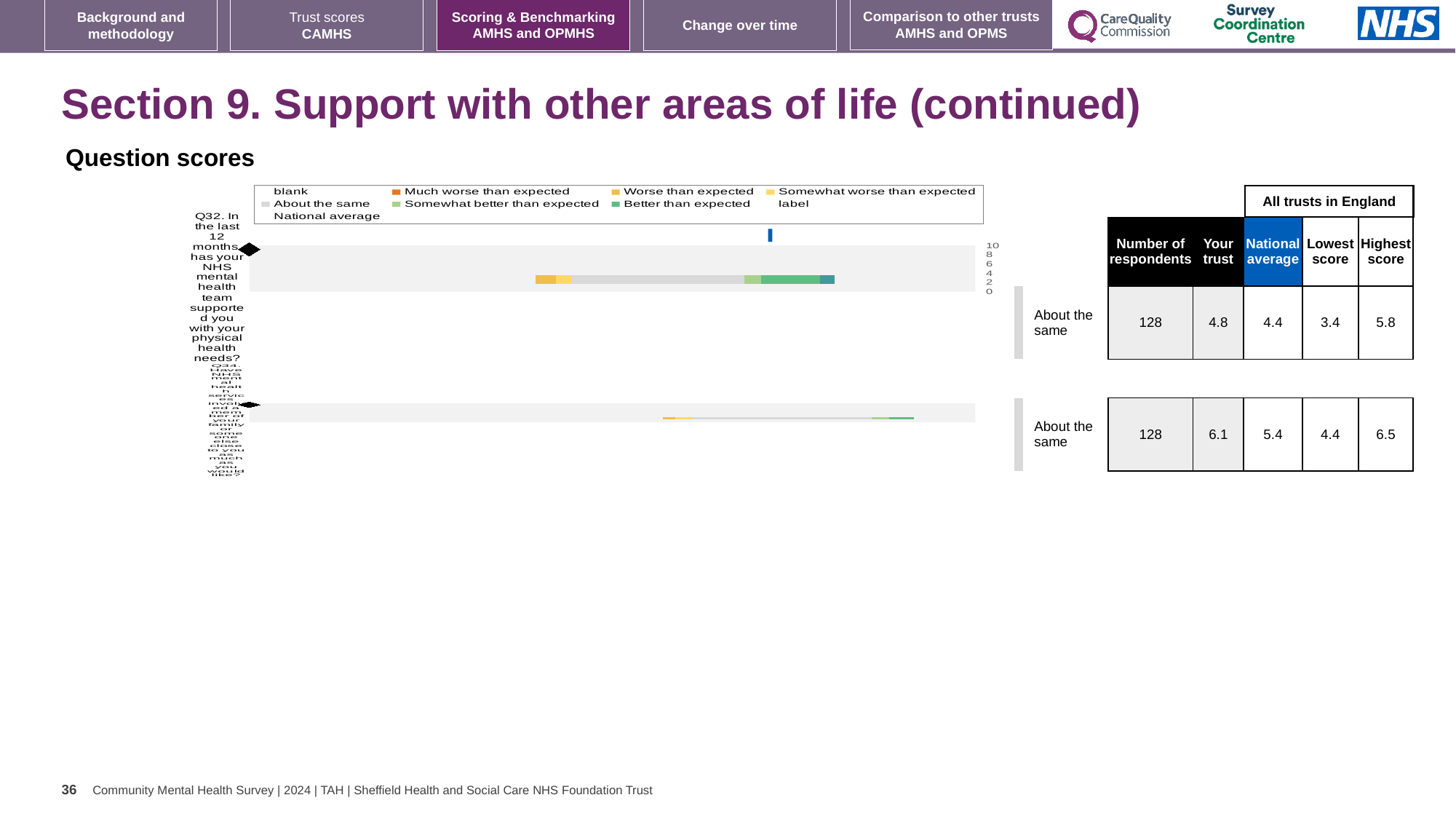
How many entries does the chart legend list? 9 Which question has the higher 'Your trust' score, Q32 or Q34? Q34 What is the 'Your trust' score for Q34 (involving family or someone close)? 6.1 What is the lowest score among all trusts in England for Q32? 3.4 How many respondents answered Q32? 128 What is the 'Your trust' score for Q32 (support with physical health needs)? 4.8 For Q34, which is larger: the trust's score or the national average? Your trust (6.1) What is the national average score for Q32? 4.4 How many questions (categories) are plotted in the chart? 2 By how much does the trust's score for Q32 exceed the national average? 0.4 What is the highest score among all trusts in England for Q34? 6.5 What kind of chart is shown under 'Question scores'? bar chart